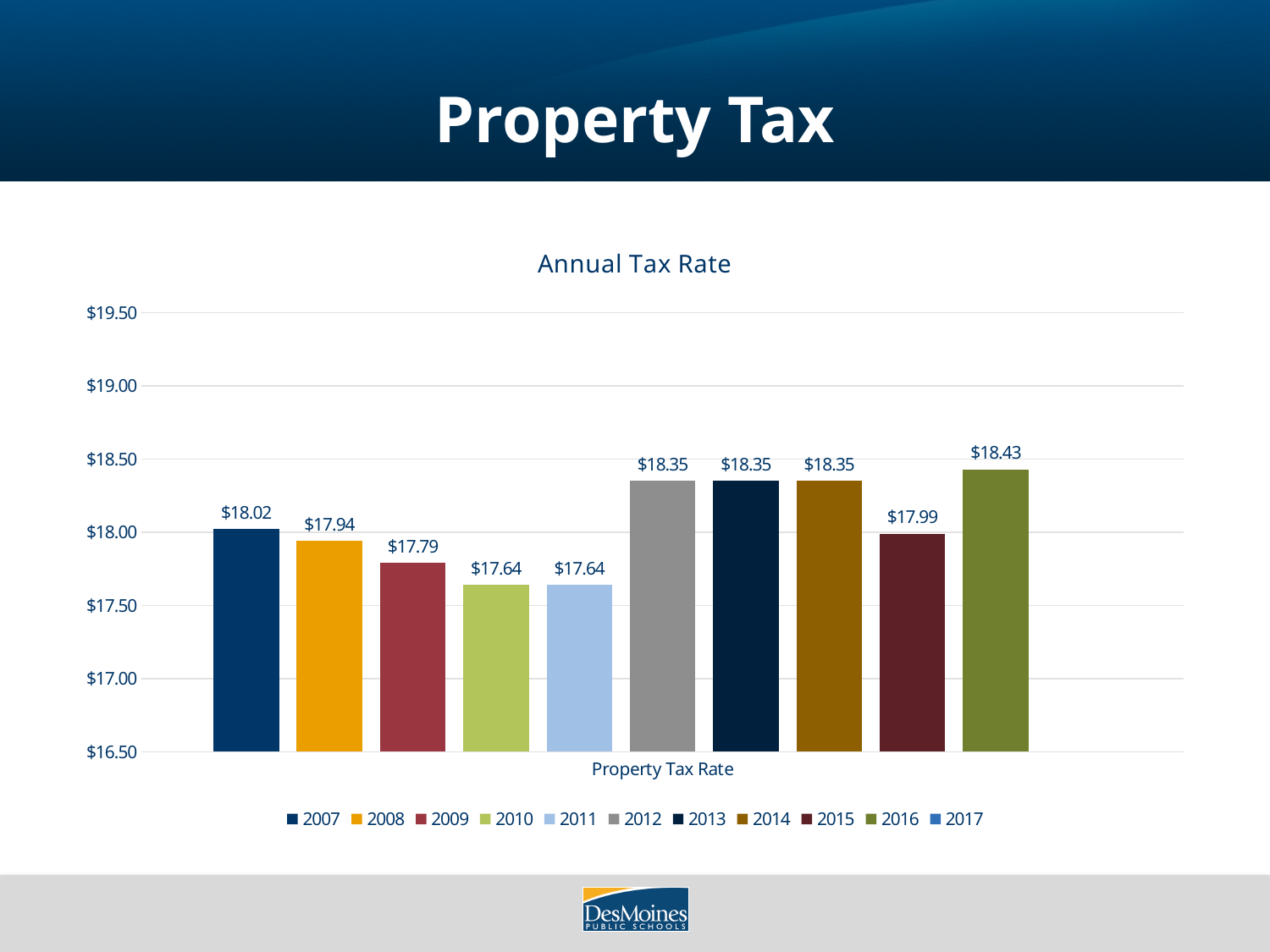
What kind of chart is shown on the slide? Bar chart How many bars are plotted in the chart? 10 What is the annual tax rate for 2007? $18.02 Is the tax rate for 2014 greater or less than $18.00? greater What is the annual tax rate for 2009? $17.79 What is the difference between the 2016 tax rate and the 2007 tax rate? $0.41 Which is larger, the tax rate for 2008 or the tax rate for 2015? 2015 Do the tax rates rise or fall from 2007 to 2011? Fall Which year has the highest annual tax rate? 2016 What is the difference between the 2012 tax rate and the 2011 tax rate? $0.71 What is the annual tax rate for 2015? $17.99 How many entries does the legend list? 11